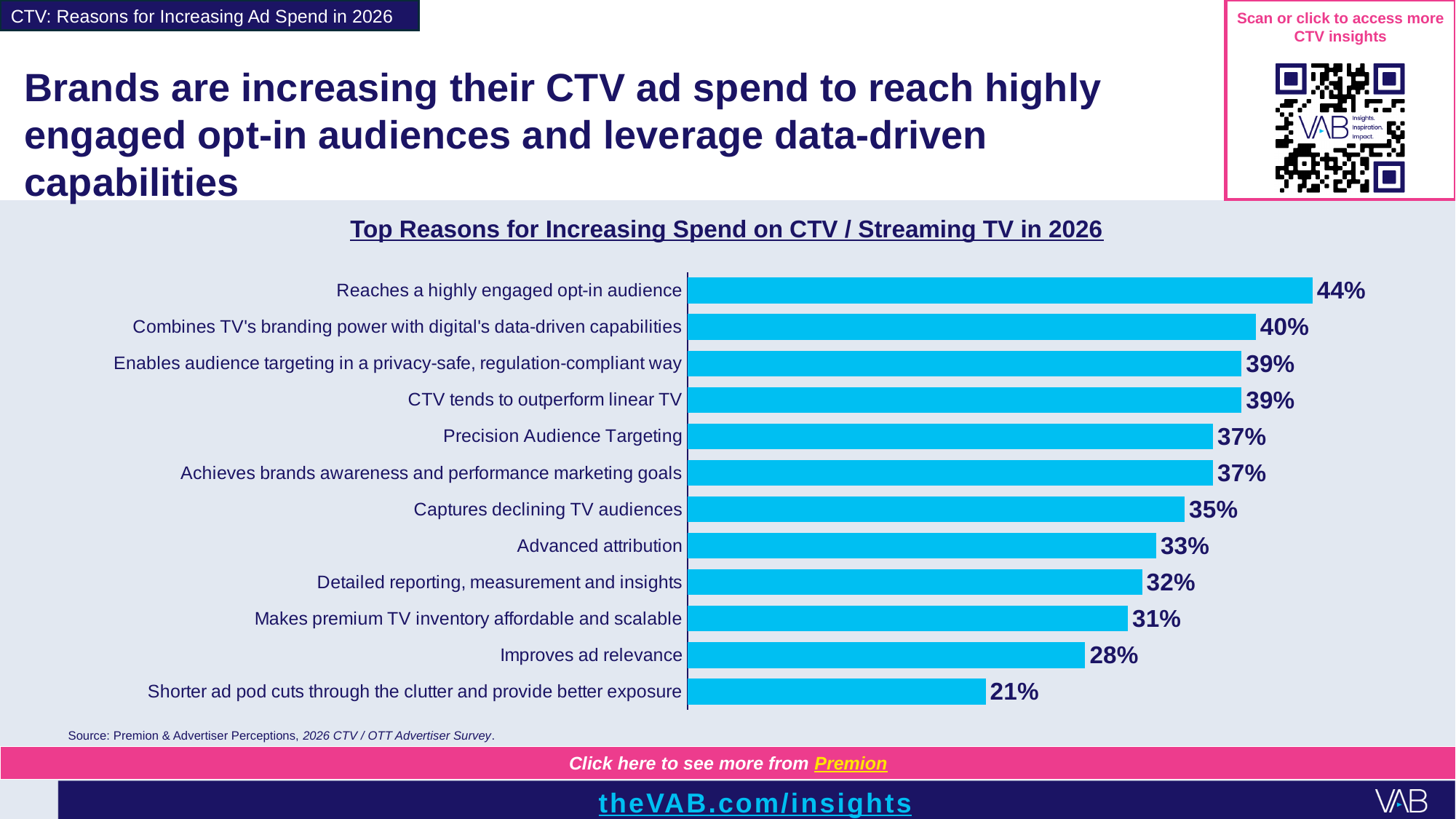
What kind of chart is shown on the slide? Bar chart Which is larger: the value for "Captures declining TV audiences" or the value for "Makes premium TV inventory affordable and scalable"? Captures declining TV audiences What percentage of respondents cited "Reaches a highly engaged opt-in audience" as a reason for increasing CTV spend? 44% What is the value for "Improves ad relevance"? 28% Which reason has the lowest percentage? Shorter ad pod cuts through the clutter and provide better exposure What is the difference between "Combines TV's branding power with digital's data-driven capabilities" and "Detailed reporting, measurement and insights"? 8 percentage points What is the value for "Advanced attribution"? 33% What is the source of the chart data? Premion & Advertiser Perceptions, 2026 CTV / OTT Advertiser Survey Which reason has the highest percentage? Reaches a highly engaged opt-in audience How many reasons are listed in the chart? 12 What is the difference between the highest value (44%) and the lowest value (21%)? 23 percentage points What is the title of the chart? Top Reasons for Increasing Spend on CTV / Streaming TV in 2026